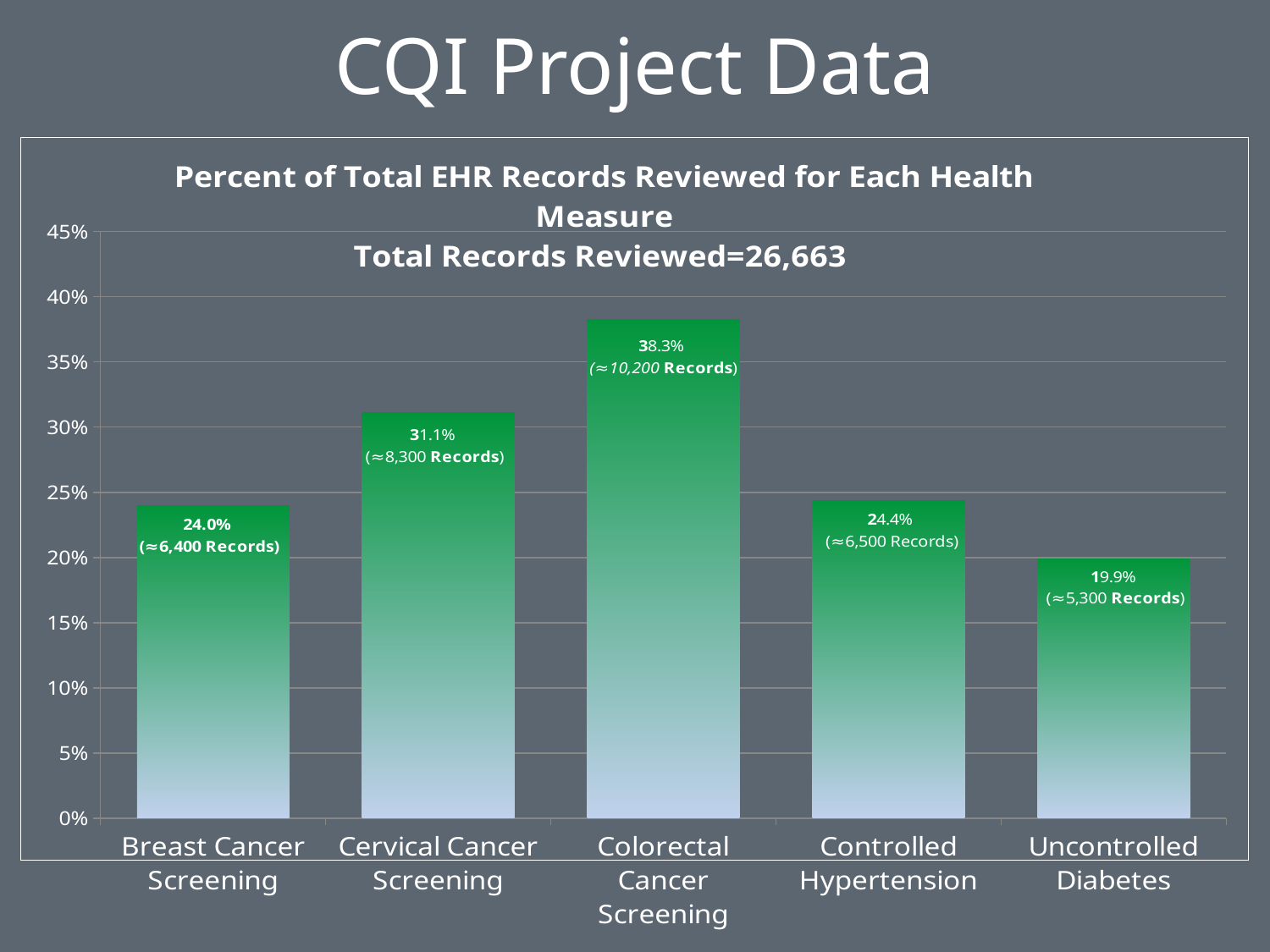
What kind of chart is shown on the slide? bar chart What is the difference in percent of records reviewed between Colorectal Cancer Screening and Cervical Cancer Screening? 7.2% What percent of total EHR records were reviewed for Cervical Cancer Screening? 31.1% Which health measure has the highest percent of records reviewed? Colorectal Cancer Screening What percent of total EHR records were reviewed for Uncontrolled Diabetes? 19.9% What is the difference in percent of records reviewed between Controlled Hypertension and Breast Cancer Screening? 0.4% How many health measures are shown on the chart? 5 Which has a larger percent of records reviewed, Breast Cancer Screening or Controlled Hypertension? Controlled Hypertension What percent of total EHR records were reviewed for Colorectal Cancer Screening? 38.3% Which health measure has the lowest percent of records reviewed? Uncontrolled Diabetes What is the total number of records reviewed stated in the chart title? 26,663 Is the value for Cervical Cancer Screening greater or less than 30%? greater